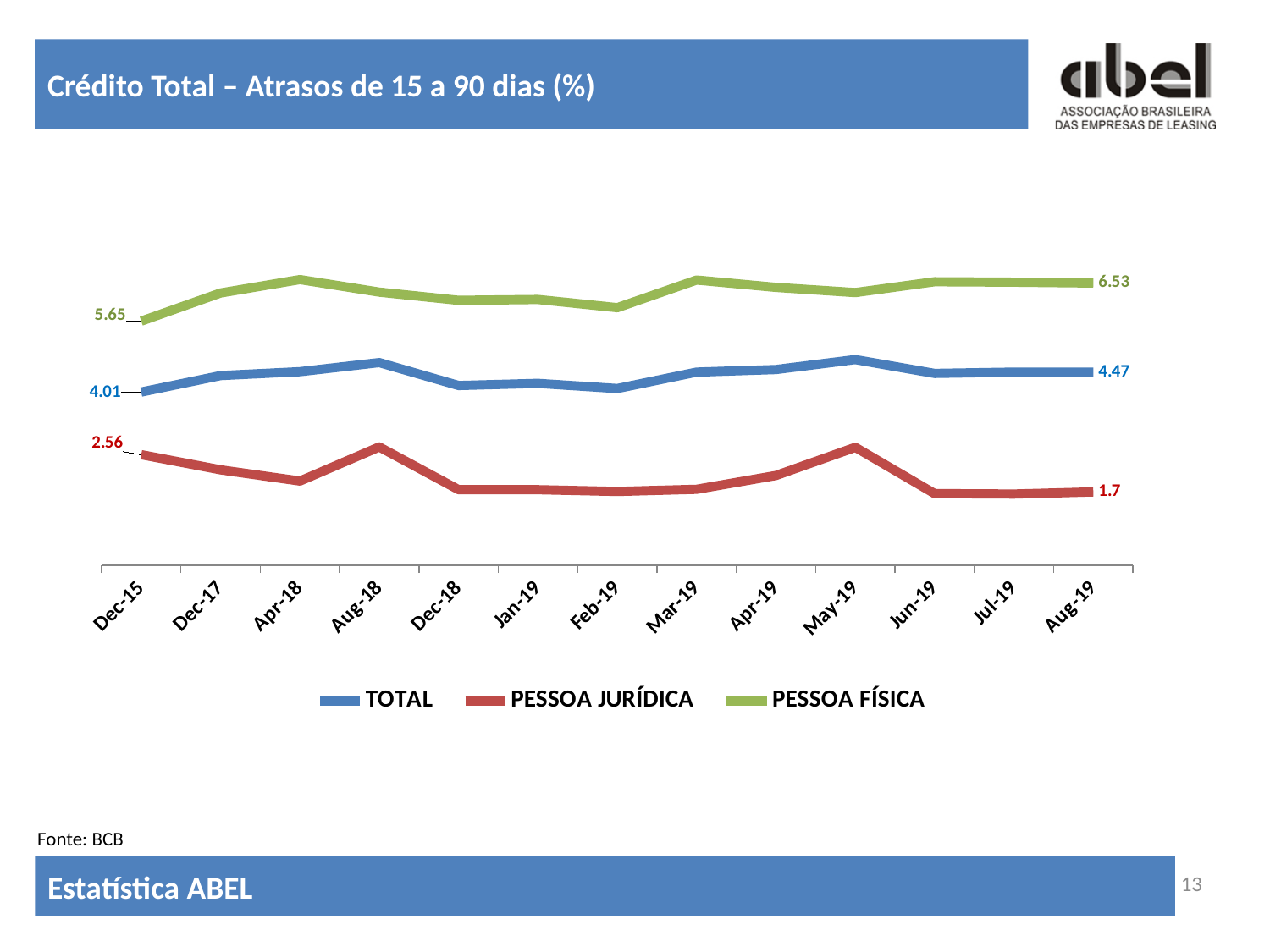
What is the value of the PESSOA FÍSICA series at Dec-15? 5.65 What is the value of the PESSOA JURÍDICA series at Aug-19? 1.7 What is the value of the TOTAL series at Aug-19? 4.47 What is the value of the PESSOA FÍSICA series at Aug-19? 6.53 By how much did the PESSOA JURÍDICA series fall from Dec-15 to Aug-19? 0.86 How many time points are shown on the x axis? 13 By how much did the PESSOA FÍSICA series change from Dec-15 to Aug-19? 0.88 What is the value of the PESSOA JURÍDICA series at Dec-15? 2.56 How many series does the legend list? 3 Which series has the highest value at Aug-19? PESSOA FÍSICA Does the PESSOA JURÍDICA series rise or fall overall from Dec-15 to Aug-19? fall What is the value of the TOTAL series at Dec-15? 4.01